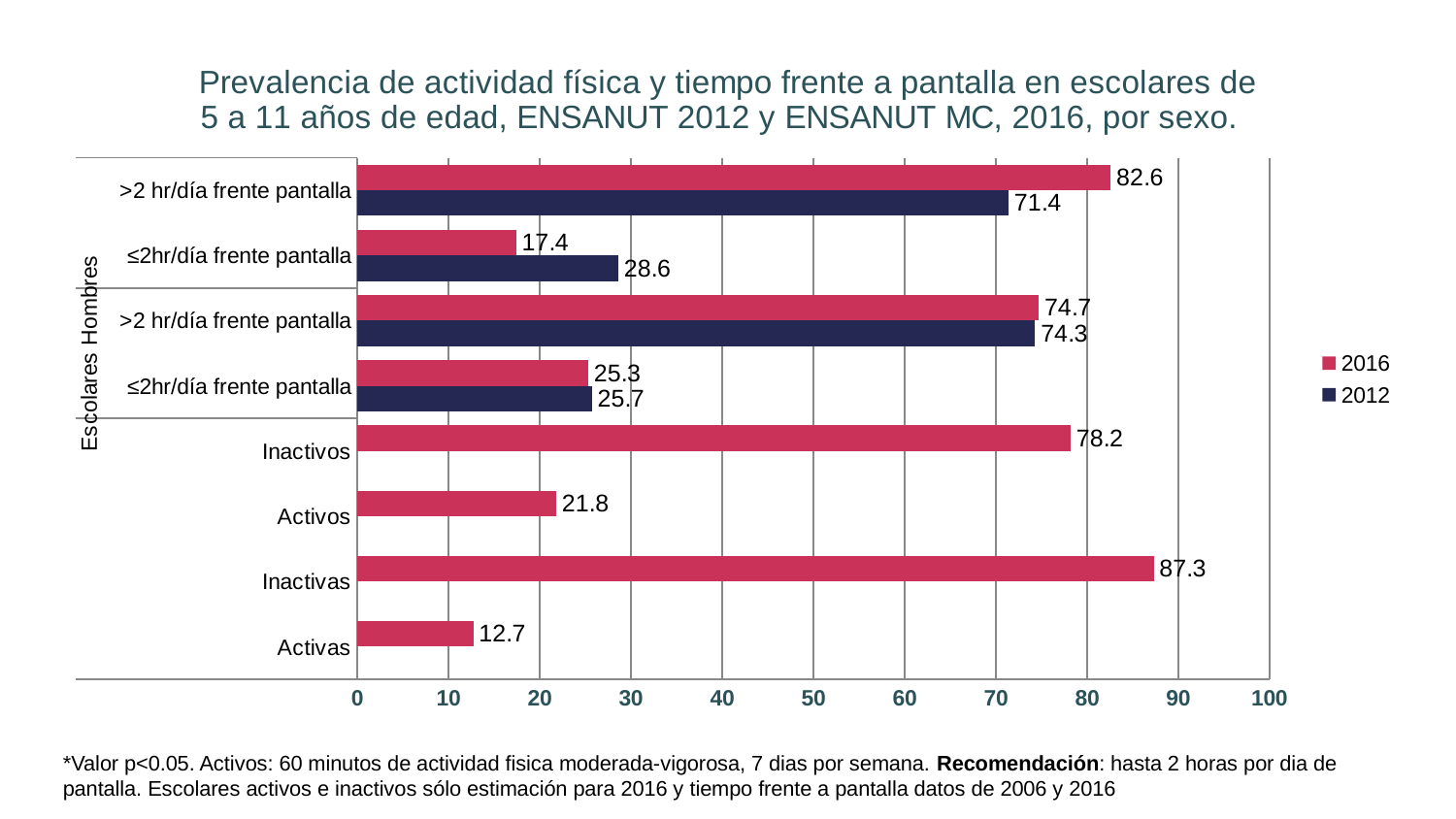
How many categories are shown on the vertical axis of the chart? 8 What are the two series named in the legend? 2016 and 2012 What is the 2012 value for the topmost '>2 hr/día frente pantalla' category? 71.4 Which category has the highest value in the chart? Inactivas Which category has the lowest value in the chart? Activas What is the value for Activas? 12.7 What kind of chart is shown on the slide? bar chart For the topmost '≤2hr/día frente pantalla' category, which series has the larger value, 2016 or 2012? 2012 What is the value for Inactivas? 87.3 What is the difference between the values for Inactivos and Activos? 56.4 What is the 2016 value for Inactivos? 78.2 How many series does the legend list? 2